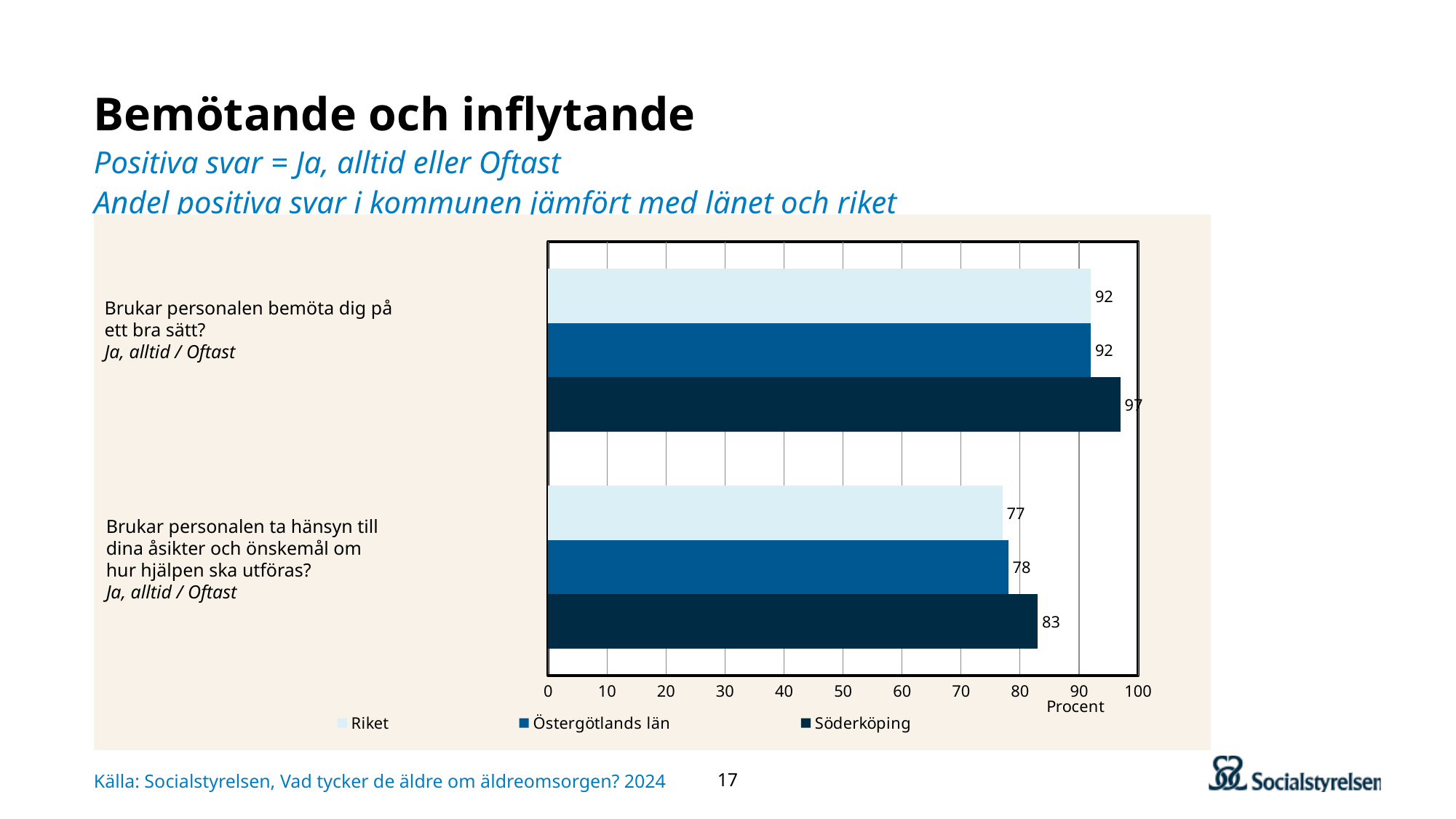
What is the value for Riket on the question 'Brukar personalen ta hänsyn till dina åsikter och önskemål om hur hjälpen ska utföras?' 77 What is the value for Riket on the question 'Brukar personalen bemöta dig på ett bra sätt?' 92 What kind of chart is shown on the slide? Bar chart What is the difference between Söderköping and Riket on the question 'Brukar personalen bemöta dig på ett bra sätt?' 5 Which is larger: Söderköping's value on 'Brukar personalen bemöta dig på ett bra sätt?' or Söderköping's value on 'Brukar personalen ta hänsyn till dina åsikter och önskemål om hur hjälpen ska utföras?' Brukar personalen bemöta dig på ett bra sätt? What is the label on the x axis of the chart? Procent Which series has the lowest value on the question 'Brukar personalen ta hänsyn till dina åsikter och önskemål om hur hjälpen ska utföras?' Riket What is the difference between Söderköping and Östergötlands län on the question 'Brukar personalen ta hänsyn till dina åsikter och önskemål om hur hjälpen ska utföras?' 5 Which series has the highest value on the question 'Brukar personalen ta hänsyn till dina åsikter och önskemål om hur hjälpen ska utföras?' Söderköping What is the value for Söderköping on the question 'Brukar personalen bemöta dig på ett bra sätt?' 97 How many series does the legend list? 3 What is the value for Östergötlands län on the question 'Brukar personalen ta hänsyn till dina åsikter och önskemål om hur hjälpen ska utföras?' 78